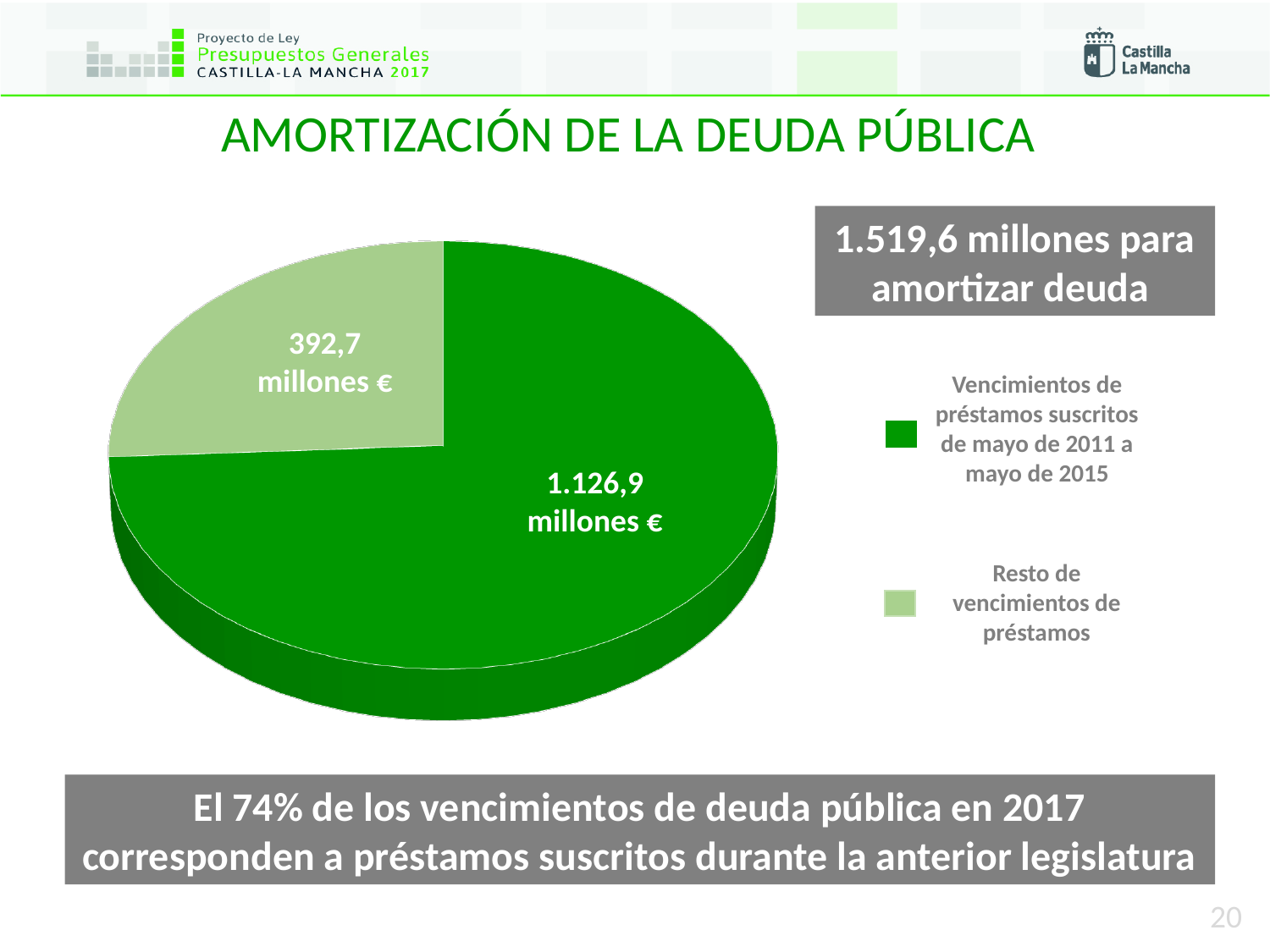
What share of the 2017 debt maturities corresponds to loans signed during the previous legislature, according to the slide? 74% How many entries does the legend list? 2 Which slice of the pie chart is the smallest? Resto de vencimientos de préstamos What is the total amount for debt amortization shown on the slide? 1.519,6 millones What kind of chart is shown on the slide? pie chart What is the difference between the two slices of the pie chart, in millones €? 734,2 millones € What is the title of the slide containing the pie chart? AMORTIZACIÓN DE LA DEUDA PÚBLICA What is the value of the slice for 'Resto de vencimientos de préstamos'? 392,7 millones € Which slice of the pie chart is the largest? Vencimientos de préstamos suscritos de mayo de 2011 a mayo de 2015 Which is larger: the slice for loans signed from May 2011 to May 2015 or the slice for the rest of loan maturities? Vencimientos de préstamos suscritos de mayo de 2011 a mayo de 2015 How many slices does the pie chart have? 2 What is the value of the slice for 'Vencimientos de préstamos suscritos de mayo de 2011 a mayo de 2015'? 1.126,9 millones €